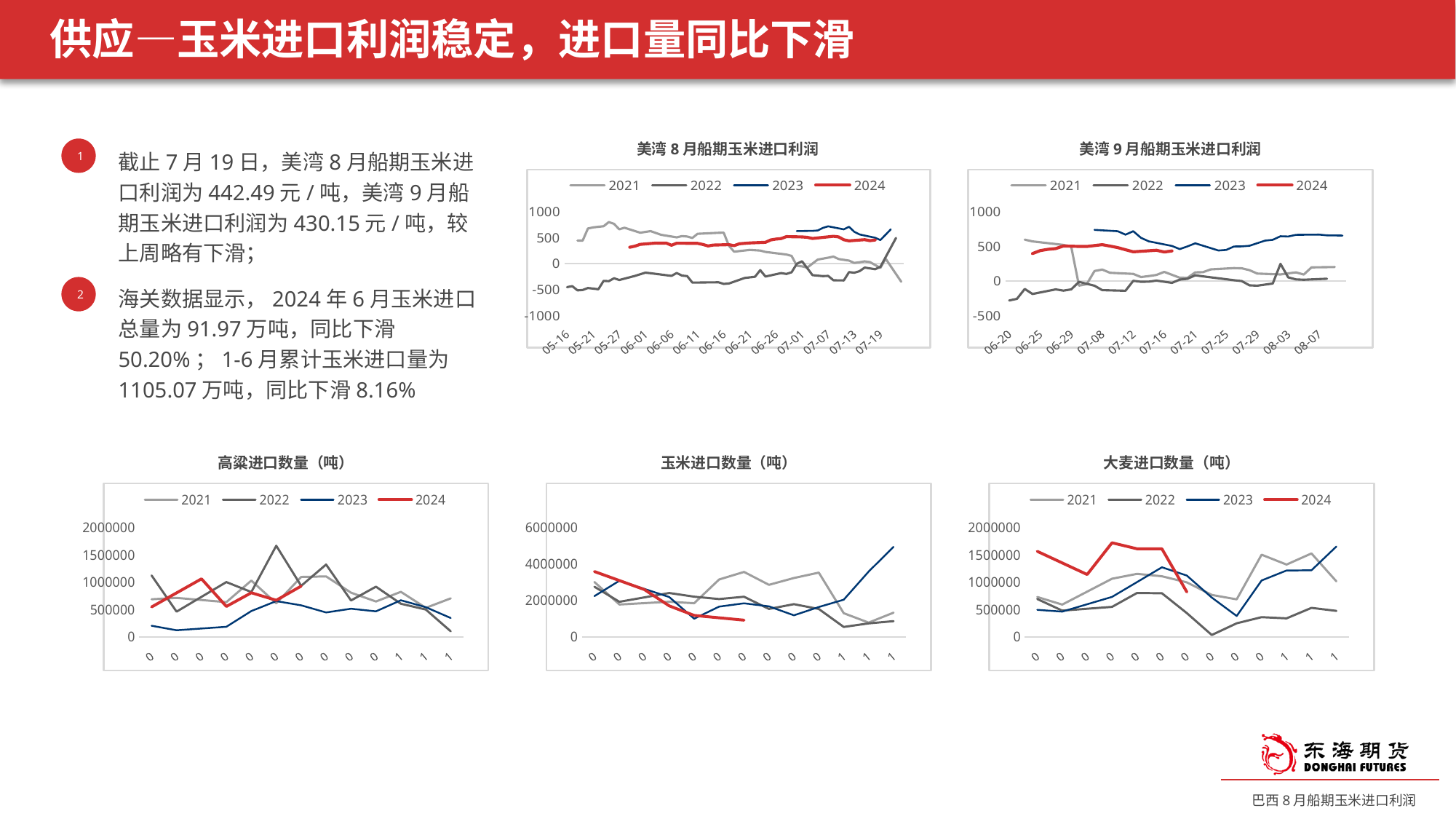
In the 玉米进口数量（吨） chart, does the 2024 line rise or fall along the x axis? fall In the 美湾9月船期玉米进口利润 chart, is the 2023 value at 08-07 greater or less than 500? greater In the 美湾8月船期玉米进口利润 chart, is the 2024 value at 07-19 greater or less than 0? greater In the 美湾8月船期玉米进口利润 chart, is the 2022 value at 05-16 greater or less than 0? less How many series does the legend of the 美湾8月船期玉米进口利润 chart list? 4 How many charts are shown on the slide? 5 How many series does the legend of the 美湾9月船期玉米进口利润 chart list? 4 What kind of chart is the 美湾8月船期玉米进口利润 chart? line chart What kind of chart is the 玉米进口数量（吨） chart? line chart In the 美湾8月船期玉米进口利润 chart, which series is drawn in red? 2024